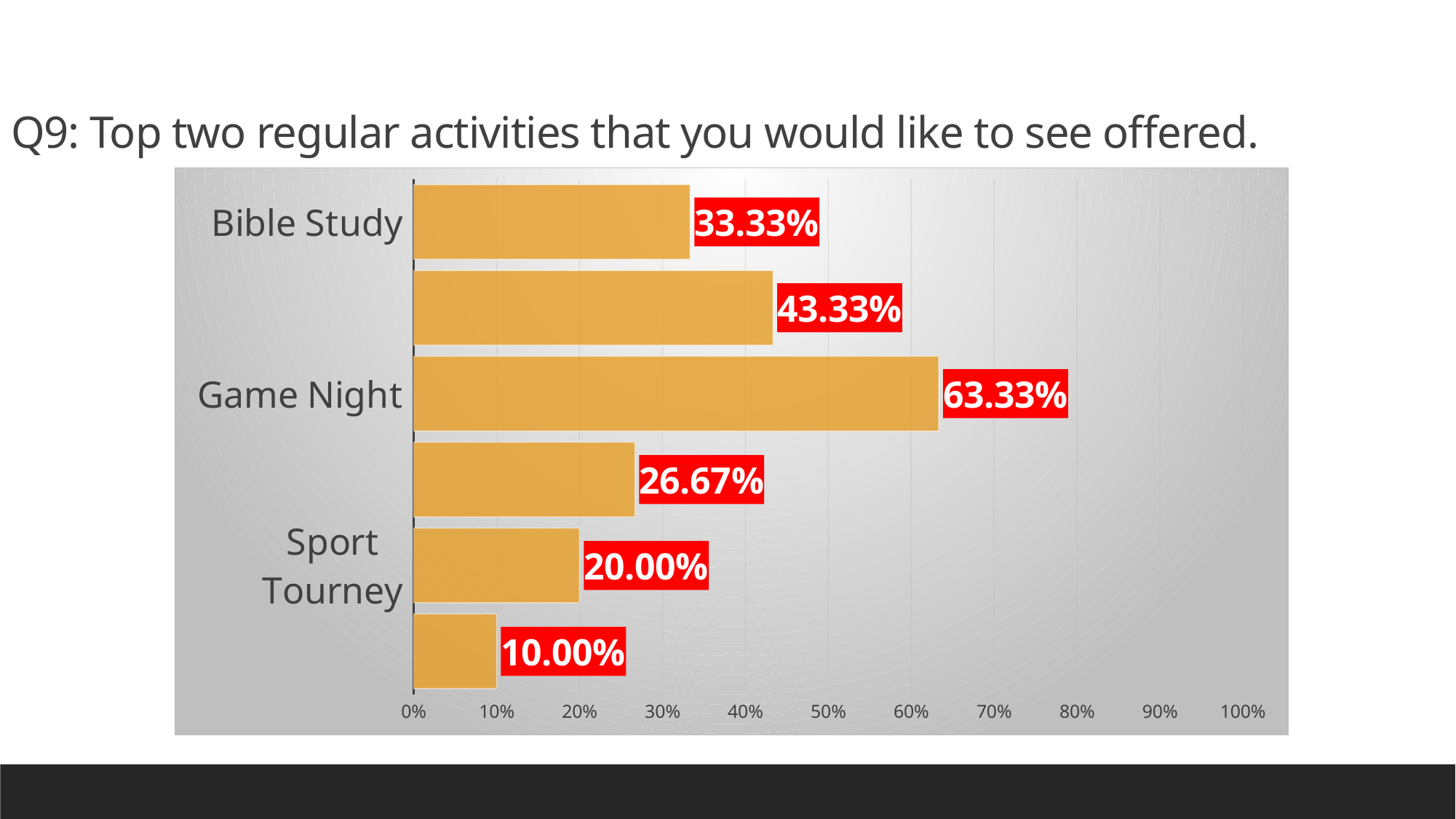
What is the value for Bible Study? 33.33% What is the title of the slide? Q9: Top two regular activities that you would like to see offered. Which is larger, the value for Bible Study or the value for Sport Tourney? Bible Study What is the difference between the values for Game Night and Bible Study? 30.00% What kind of chart is shown on the slide? Bar chart Is the value for Sport Tourney greater or less than 30%? less What is the value for Game Night? 63.33% What is the smallest value shown on the chart? 10.00% What is the value for Sport Tourney? 20.00% What is the difference between the values for Bible Study and Sport Tourney? 13.33% How many bars are plotted on the chart? 6 Which category has the highest value? Game Night